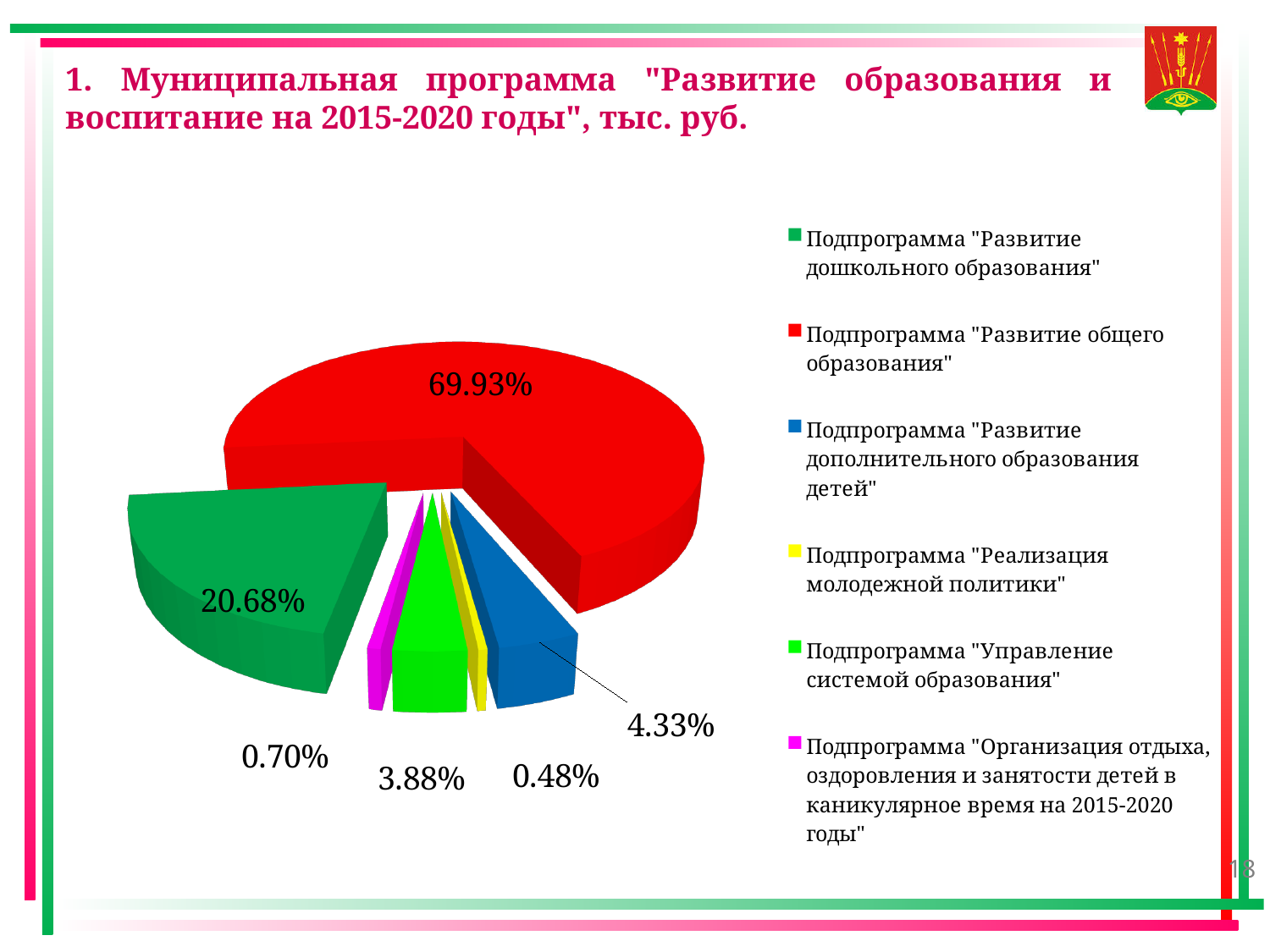
Which subprogram has the smallest share of the pie? Подпрограмма "Реализация молодежной политики" What colour is the slice for the subprogram "Развитие общего образования"? red What share of the pie does the subprogram "Развитие дополнительного образования детей" have? 4.33% What share of the pie does the subprogram "Развитие общего образования" have? 69.93% What share of the pie does the subprogram "Управление системой образования" have? 3.88% How many entries does the legend list? 6 Which has the larger share: "Развитие дополнительного образования детей" or "Управление системой образования"? Подпрограмма "Развитие дополнительного образования детей" How many slices does the pie chart have? 6 What share of the pie does the subprogram "Развитие дошкольного образования" have? 20.68% Which subprogram has the largest share of the pie? Подпрограмма "Развитие общего образования" What is the difference in percentage points between the shares of "Развитие общего образования" and "Развитие дошкольного образования"? 49.25 What kind of chart is shown on the slide? pie chart